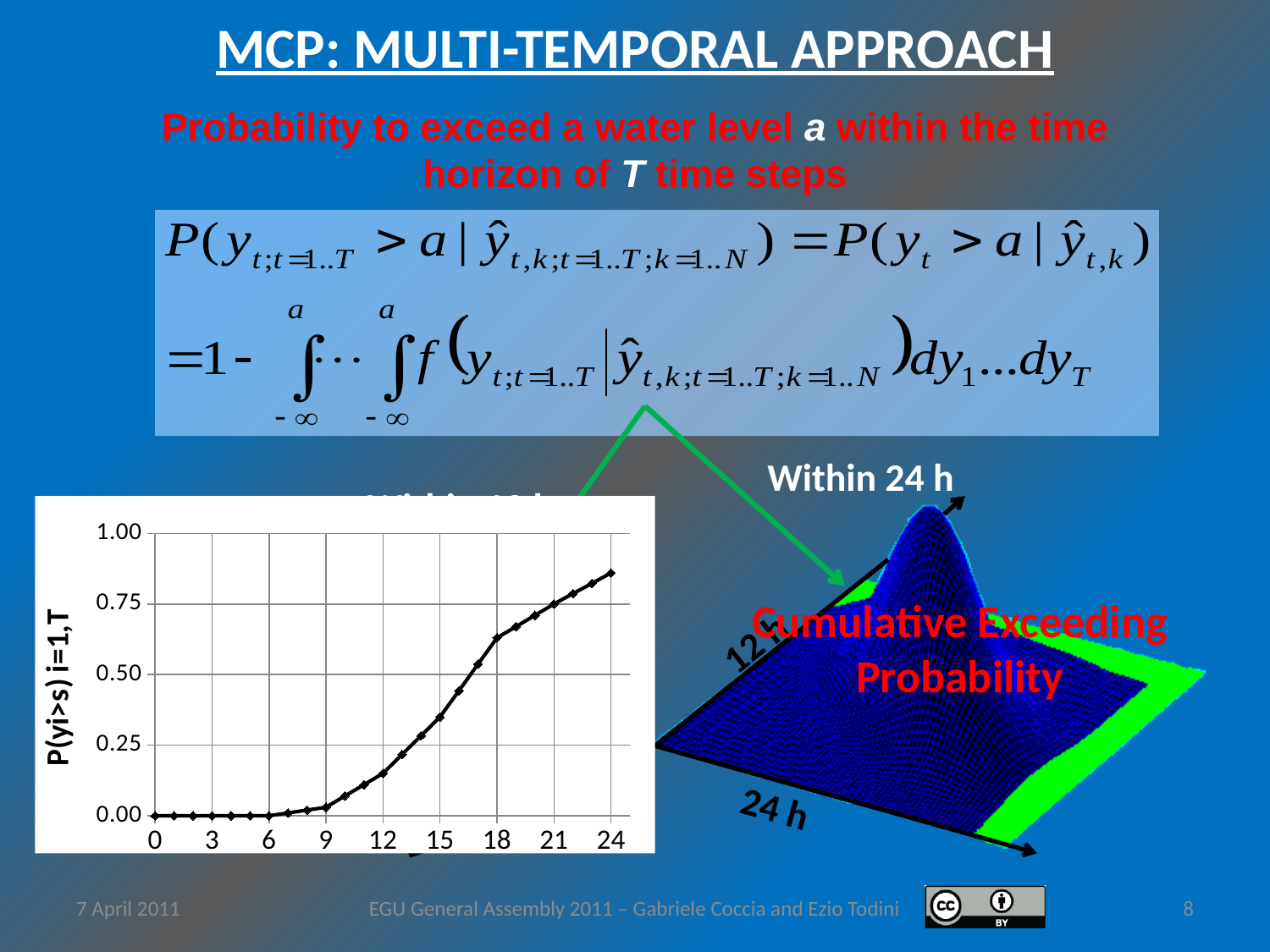
In the line chart, is the value at x = 12 greater or less than 0.25? less In the line chart, is the value at x = 15 greater or less than 0.50? less In the line chart, do the values rise or fall as the x axis goes from 0 to 24? rise In the line chart, is the value at x = 6 greater or less than 0.25? less In the line chart, what is the plotted value at x = 0? 0.00 In the line chart, at which x value is the plotted probability highest? 24 What kind of chart is shown at the bottom left of the slide? line chart What is the highest tick value shown on the y axis of the line chart? 1.00 What is the label of the y axis of the line chart? P(yi>s) i=1,T In the line chart, which has the larger value: x = 24 or x = 12? 24